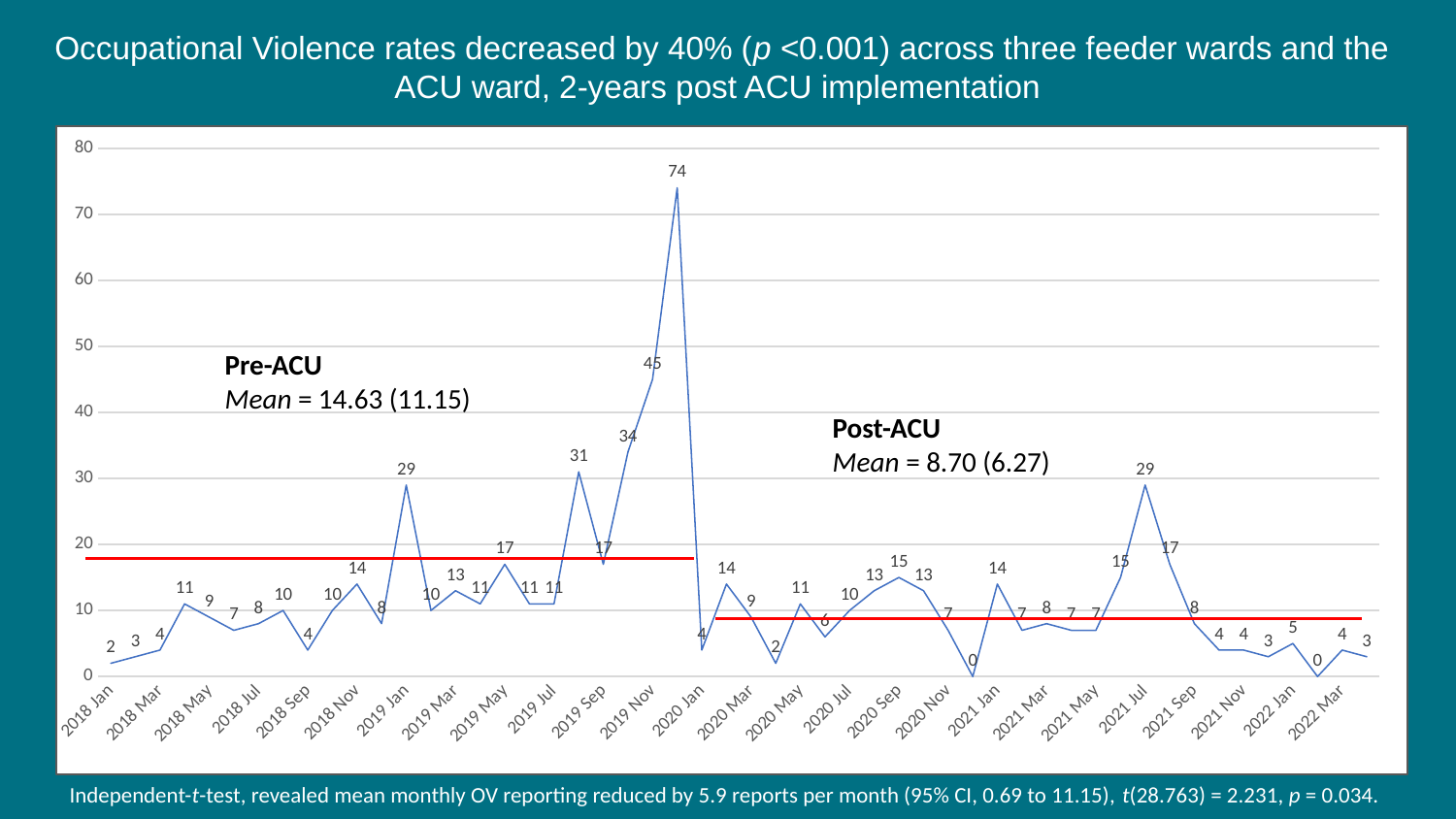
What is the value plotted for 2018 Jan? 2 What is the value plotted for 2019 Jan? 29 What is the Pre-ACU mean shown on the chart? 14.63 (11.15) What is the highest monthly value plotted on the chart? 74 Is the value for 2019 Jan greater or less than 20? greater Is the Post-ACU mean higher or lower than the Pre-ACU mean? lower What is the lowest monthly value plotted on the chart? 0 Which is larger, the value for 2019 Jan or the value for 2018 Jan? 2019 Jan What is the difference between the peak value of 74 and the 2019 Jan value of 29? 45 What is the maximum value shown on the vertical axis? 80 What kind of chart is shown on the slide? line chart What is the Post-ACU mean shown on the chart? 8.70 (6.27)